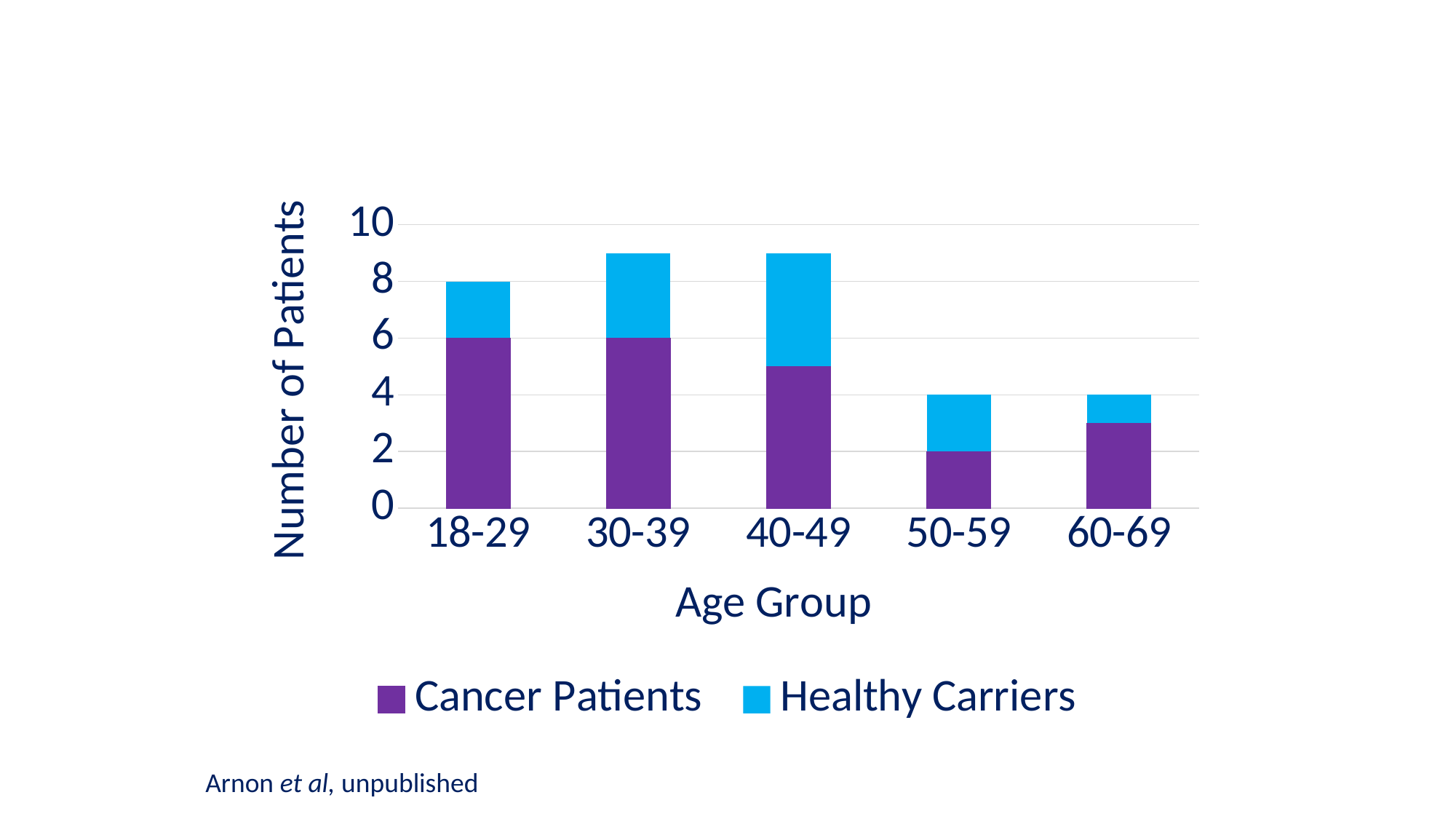
What kind of chart is shown on the slide? bar chart What is the number of Cancer Patients in the 18-29 age group? 6 How many age groups are shown on the x axis? 5 What is the total number of patients (Cancer Patients plus Healthy Carriers) in the 18-29 age group? 8 Which age group has a larger total number of patients, 18-29 or 60-69? 18-29 Is the total number of patients in the 30-39 age group greater or less than 8? greater What is the number of Cancer Patients in the 50-59 age group? 2 How many series does the legend list? 2 Which age group has the lowest number of Cancer Patients? 50-59 What is the total number of patients in the 50-59 age group? 4 What is the label of the y axis? Number of Patients Which age group has the highest number of Healthy Carriers? 40-49